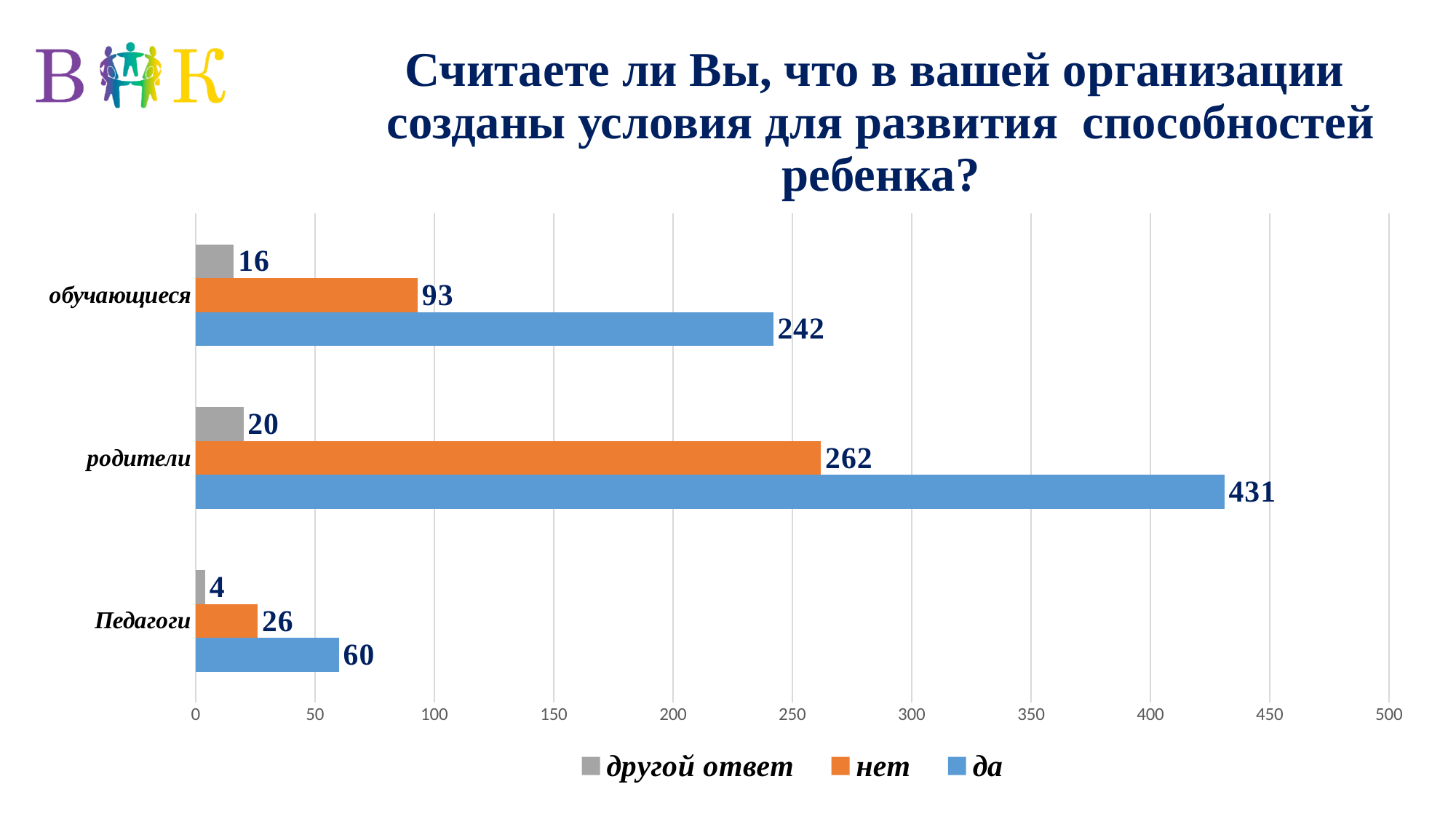
What kind of chart is shown on the slide? bar chart Which category has the highest value for "да"? родители Is the "да" value for обучающиеся greater or less than 200? greater What is the difference between the "да" and "нет" values for родители? 169 How many categories are shown on the chart? 3 Which category has the lowest value for "нет"? Педагоги What is the value for "нет" for обучающиеся? 93 What is the value for "другой ответ" for Педагоги? 4 How many series does the legend list? 3 What is the value for "да" for родители? 431 Which is larger: the "да" value for обучающиеся or the "нет" value for родители? нет value for родители What colour are the bars for the "нет" series? orange